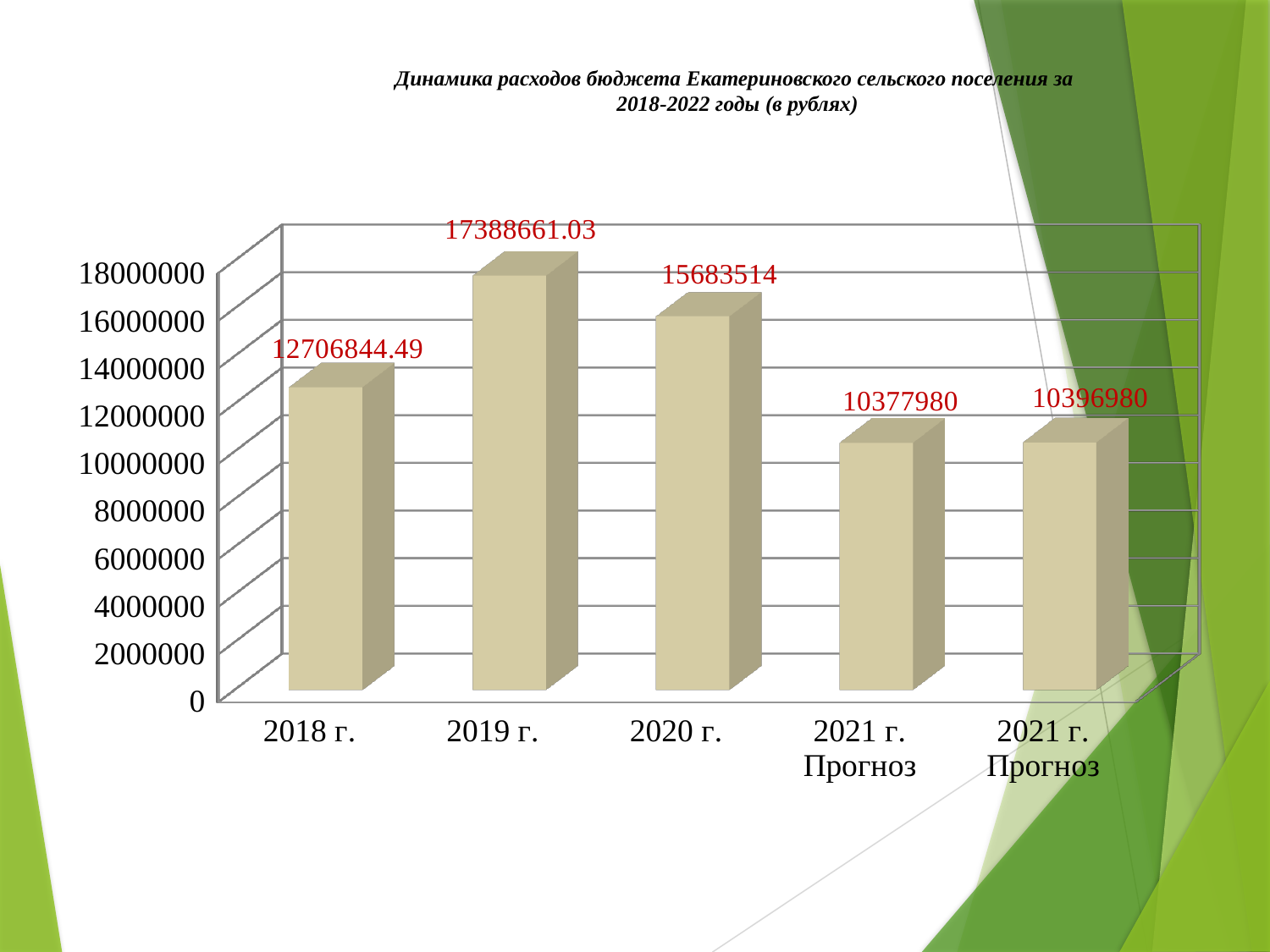
What is the value shown on the fourth bar (the first one labelled 2021 г. Прогноз)? 10377980 Which year has the highest value? 2019 г. What is the value shown on the last (fifth) bar? 10396980 Is the value for 2019 г. greater or less than 16000000? greater What kind of chart is shown on the slide? bar chart What is the value for 2018 г.? 12706844.49 What is the value for 2019 г.? 17388661.03 What is the difference between the values for 2019 г. and 2020 г.? 1705147.03 What is the value for 2020 г.? 15683514 What is the difference between the values for 2019 г. and 2018 г.? 4681816.54 Which is larger, the value for 2020 г. or the value for 2018 г.? 2020 г. How many bars are shown in the chart? 5